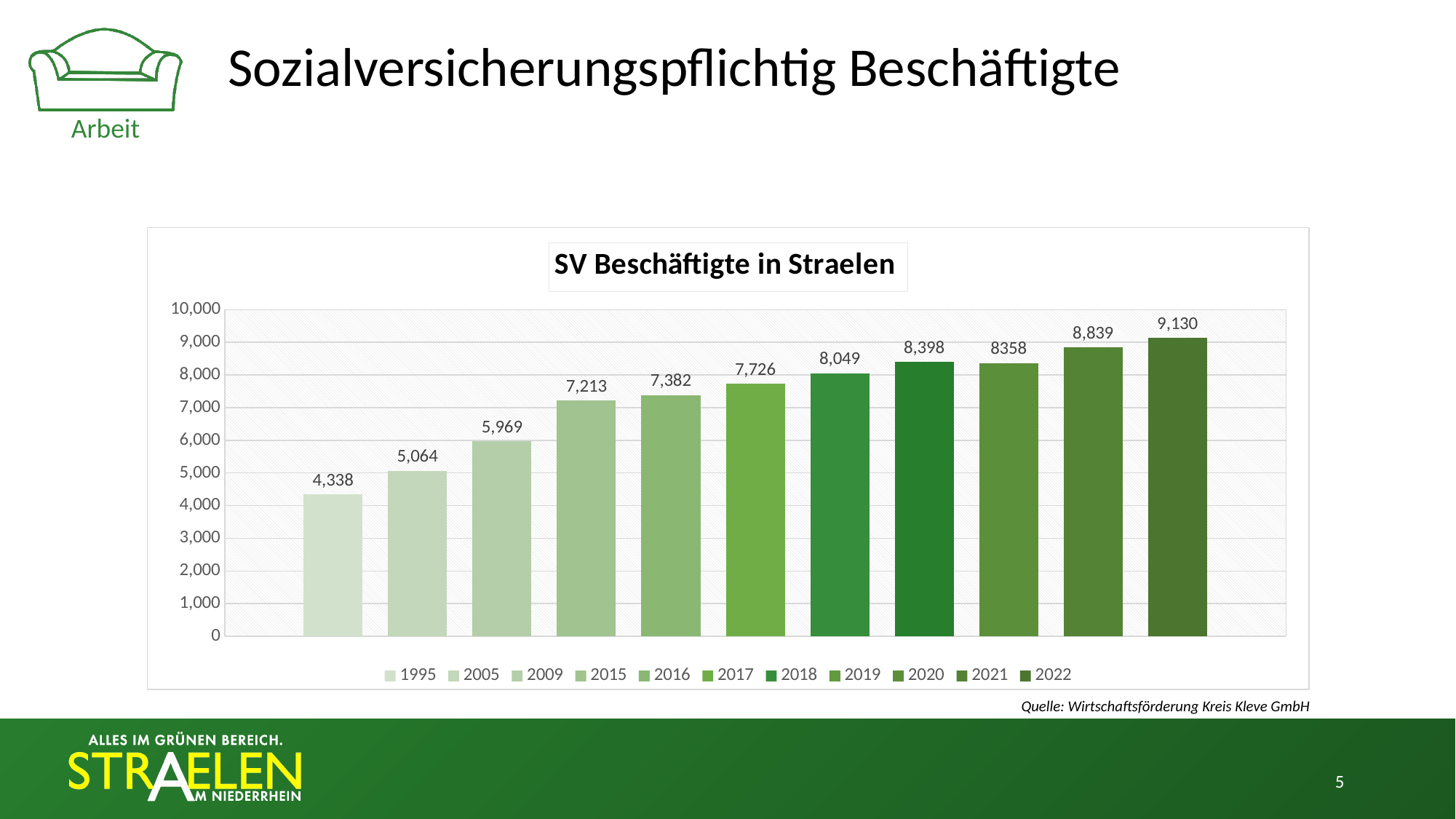
What is the value for 2020 in the chart 'SV Beschäftigte in Straelen'? 8358 What is the value for 2017 in the chart 'SV Beschäftigte in Straelen'? 7,726 What is the value for 1995 in the chart 'SV Beschäftigte in Straelen'? 4,338 Which year has the lowest value in the chart 'SV Beschäftigte in Straelen'? 1995 Do the values in the chart 'SV Beschäftigte in Straelen' generally rise or fall from 1995 to 2022? rise What is the difference between the values for 2022 and 1995 in the chart 'SV Beschäftigte in Straelen'? 4,792 What kind of chart is 'SV Beschäftigte in Straelen'? bar chart Is the value for 2009 in the chart 'SV Beschäftigte in Straelen' greater or less than 6,000? less What is the difference between the values for 2021 and 2020 in the chart 'SV Beschäftigte in Straelen'? 481 How many bars are shown in the chart 'SV Beschäftigte in Straelen'? 11 Which year has the highest value in the chart 'SV Beschäftigte in Straelen'? 2022 Which is larger in the chart 'SV Beschäftigte in Straelen', the value for 2019 or the value for 2020? 2019